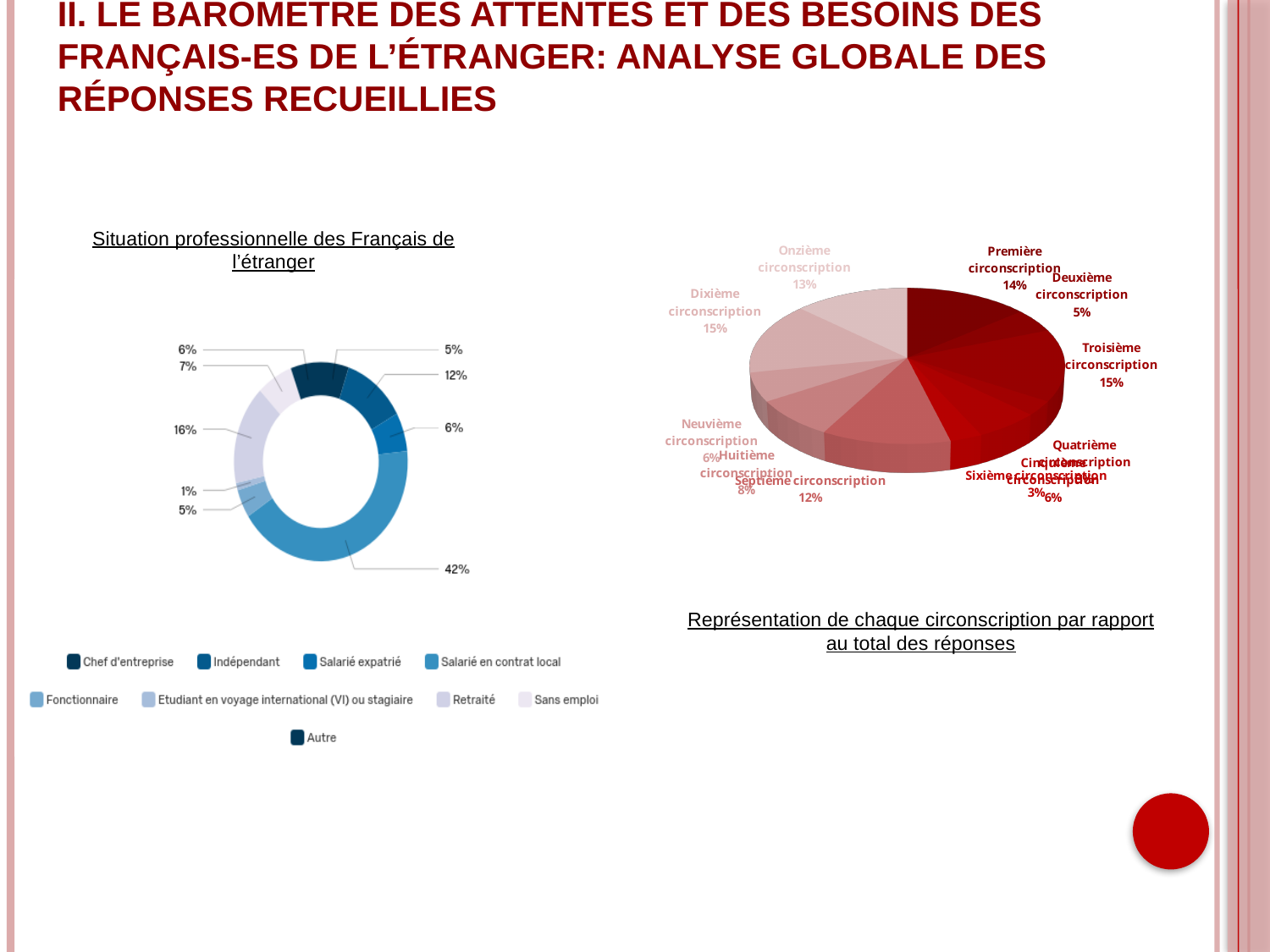
What kind of chart is the chart titled 'Représentation de chaque circonscription par rapport au total des réponses'? Pie chart In the chart 'Représentation de chaque circonscription par rapport au total des réponses', what is the share of the Onzième circonscription? 13% In the chart 'Représentation de chaque circonscription par rapport au total des réponses', what is the share of the Dixième circonscription? 15% In the chart 'Représentation de chaque circonscription par rapport au total des réponses', what is the share of the Sixième circonscription? 3% In the chart 'Situation professionnelle des Français de l'étranger', what is the smallest percentage shown? 1% In the chart 'Représentation de chaque circonscription par rapport au total des réponses', which has the larger share: the Septième circonscription or the Huitième circonscription? Septième circonscription In the chart 'Représentation de chaque circonscription par rapport au total des réponses', what is the share of the Première circonscription? 14% In the chart 'Situation professionnelle des Français de l'étranger', which category has the largest share? Salarié en contrat local What kind of chart is the chart titled 'Situation professionnelle des Français de l'étranger'? Donut chart In the chart 'Représentation de chaque circonscription par rapport au total des réponses', what is the difference in percentage points between the Première circonscription and the Deuxième circonscription? 9 percentage points How many categories does the legend of the chart 'Situation professionnelle des Français de l'étranger' list? 9 In the chart 'Situation professionnelle des Français de l'étranger', what is the largest percentage shown? 42%